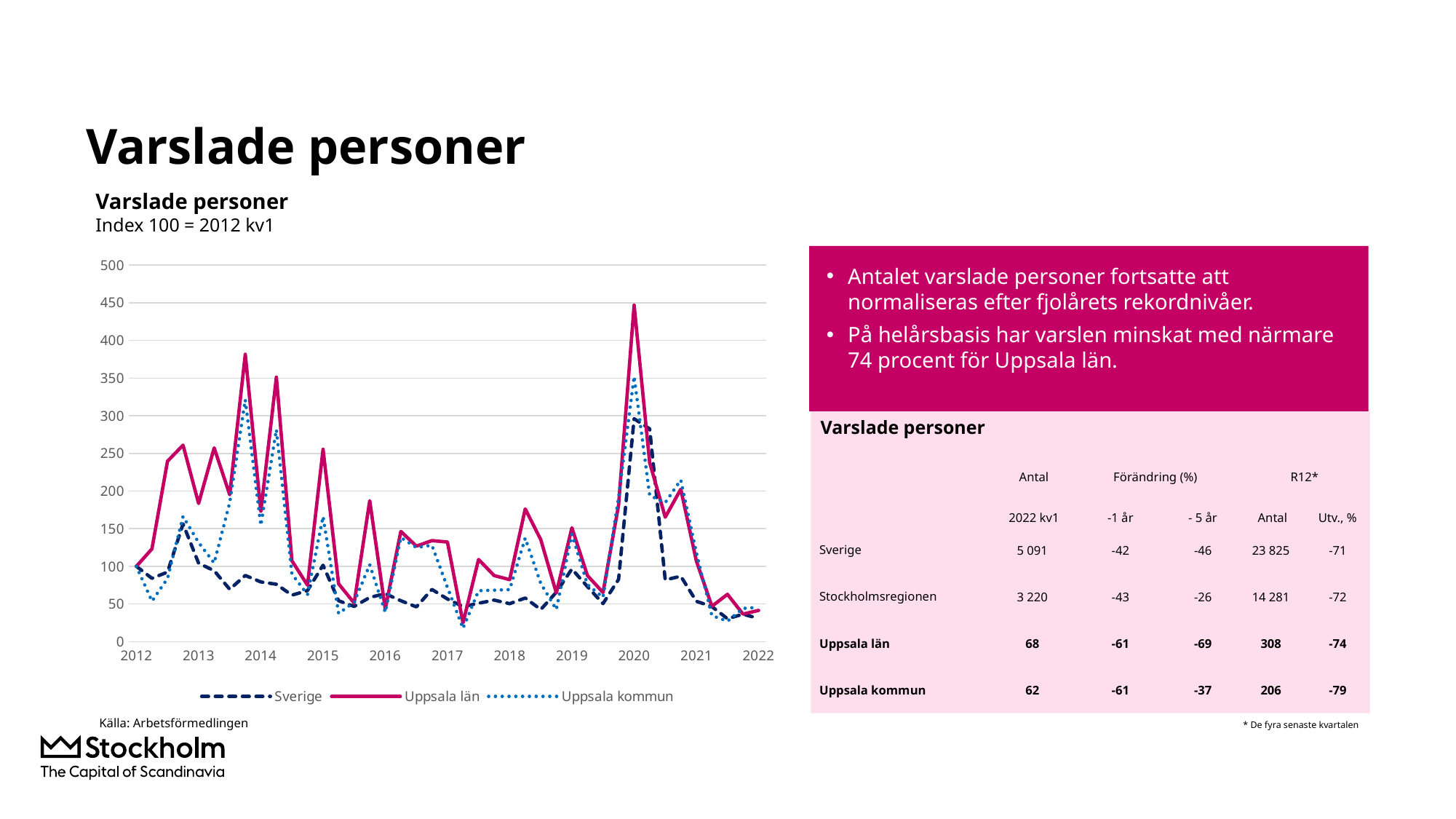
Which series are listed in the chart legend? Sverige, Uppsala län, Uppsala kommun Which series reaches the highest peak in 2020? Uppsala län What is the index base stated under the chart title? Index 100 = 2012 kv1 Is the peak value for Sverige in 2020 greater or less than 250? greater Is the peak value for Uppsala län in 2020 greater or less than 400? greater Is the value for Uppsala län at the end of the series in 2022 greater or less than 100? less What is the highest value shown on the chart's vertical axis? 500 Do the values for Uppsala län rise or fall from the 2020 peak to 2022? fall How many series does the chart legend list? 3 In which year does the Uppsala län series reach its highest value? 2020 What kind of chart is shown on the slide? line chart